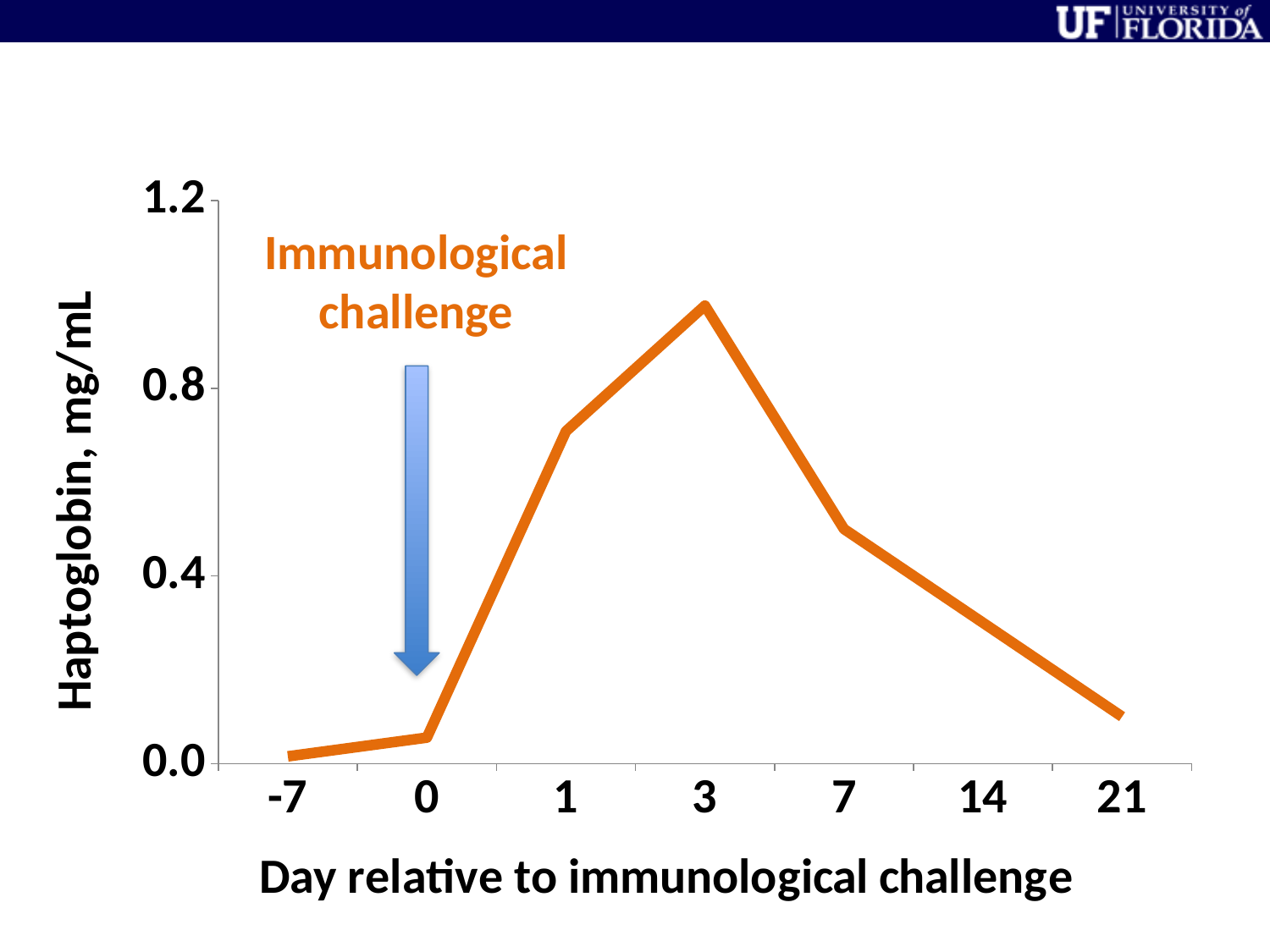
Which day has the higher haptoglobin value, day 1 or day 7? 1 Is the haptoglobin value on day 3 greater or less than 0.8? greater On which day is haptoglobin lowest? -7 Is the haptoglobin value on day 1 greater or less than 0.4? greater What kind of chart is shown on the slide? line chart On which day is haptoglobin highest? 3 What is the label of the y axis? Haptoglobin, mg/mL Is the haptoglobin value on day 21 greater or less than 0.4? less Does haptoglobin rise or fall from day 3 to day 21? fall What event does the blue arrow on the chart mark? Immunological challenge How many days (data points) are plotted along the x axis? 7